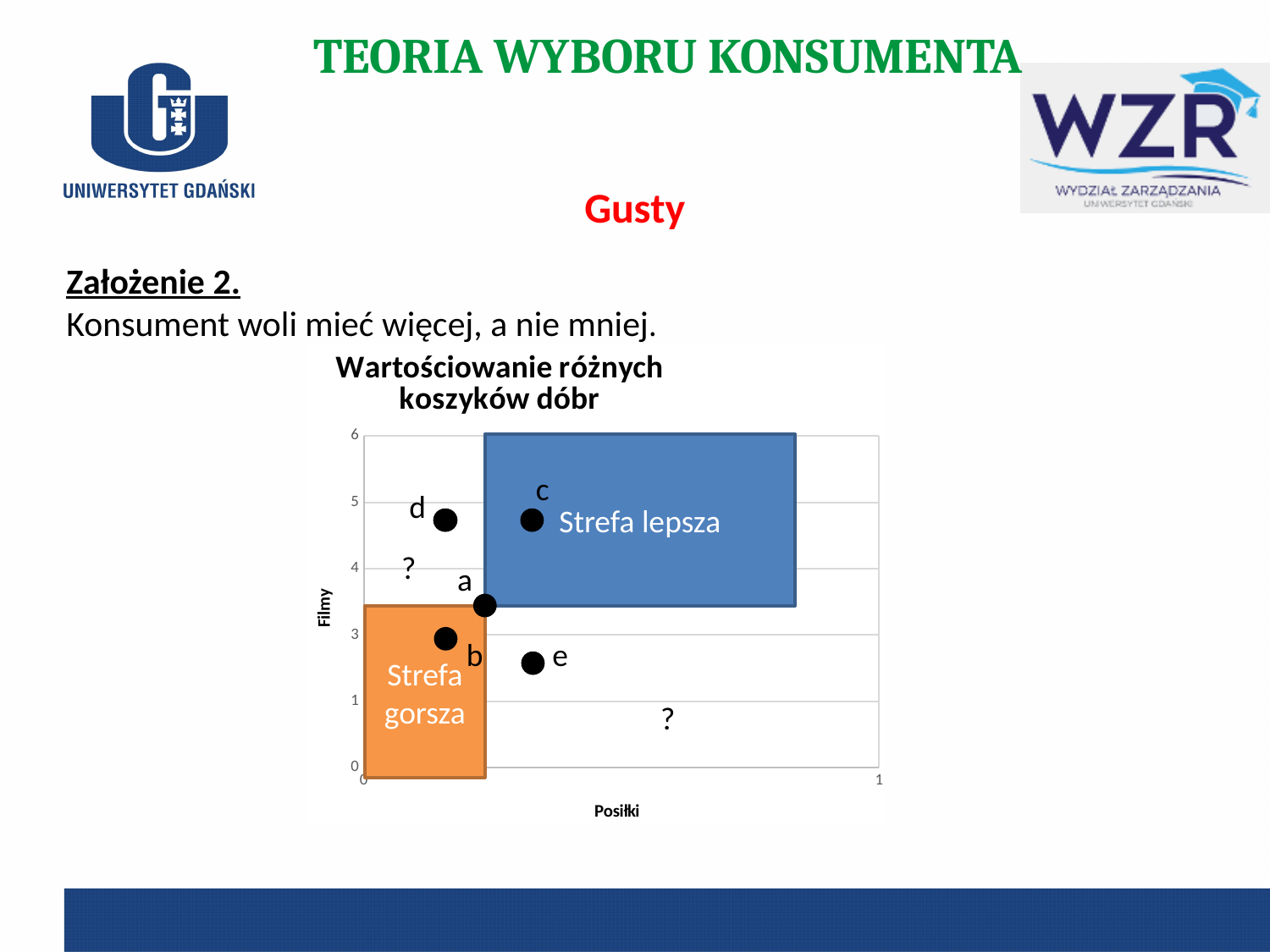
What kind of chart is shown on the slide? scatter chart Is the Filmy value for point e greater or less than 1? greater Which point has a higher Filmy value, d or b? d What label is written inside the blue rectangle on the chart? Strefa lepsza Is the Filmy value for point e greater or less than 3? less Which labelled point has the lowest Filmy value? e Which point has a higher Filmy value, c or e? c Is the Filmy value for point d greater or less than 4? greater What is the title of the chart? Wartościowanie różnych koszyków dóbr How many labelled data points are plotted on the chart? 5